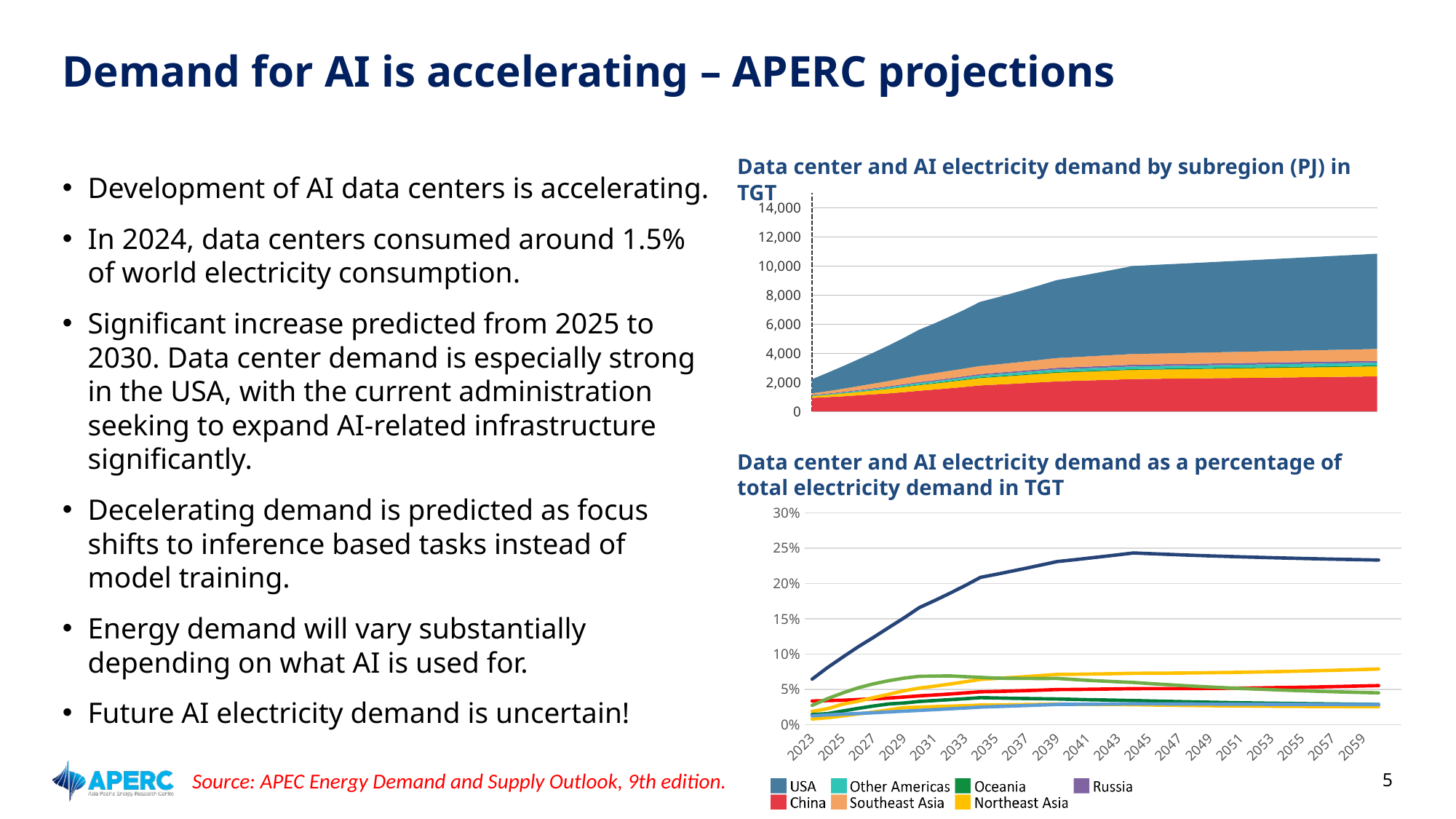
What kind of chart is the top chart, 'Data center and AI electricity demand by subregion (PJ) in TGT'? Stacked area chart In the bottom chart, which subregion has the highest data center and AI share of total electricity demand in 2059? USA In the bottom chart, how many year labels are shown on the x axis? 19 In the top chart, which subregion accounts for the largest share of data center and AI electricity demand in 2059? USA In the bottom chart, is the USA value in 2023 greater or less than 10%? less How many series does the legend at the bottom of the slide list? 7 In the bottom chart, is the USA value in 2045 greater or less than 20%? greater In the top chart, is the total data center and AI electricity demand in 2023 greater or less than 4,000 PJ? less In the bottom chart, which is larger in 2059: the value for USA or the value for China? USA In the top chart, does total data center and AI electricity demand rise or fall from 2023 to 2059? Rises What kind of chart is the bottom chart, 'Data center and AI electricity demand as a percentage of total electricity demand in TGT'? Line chart